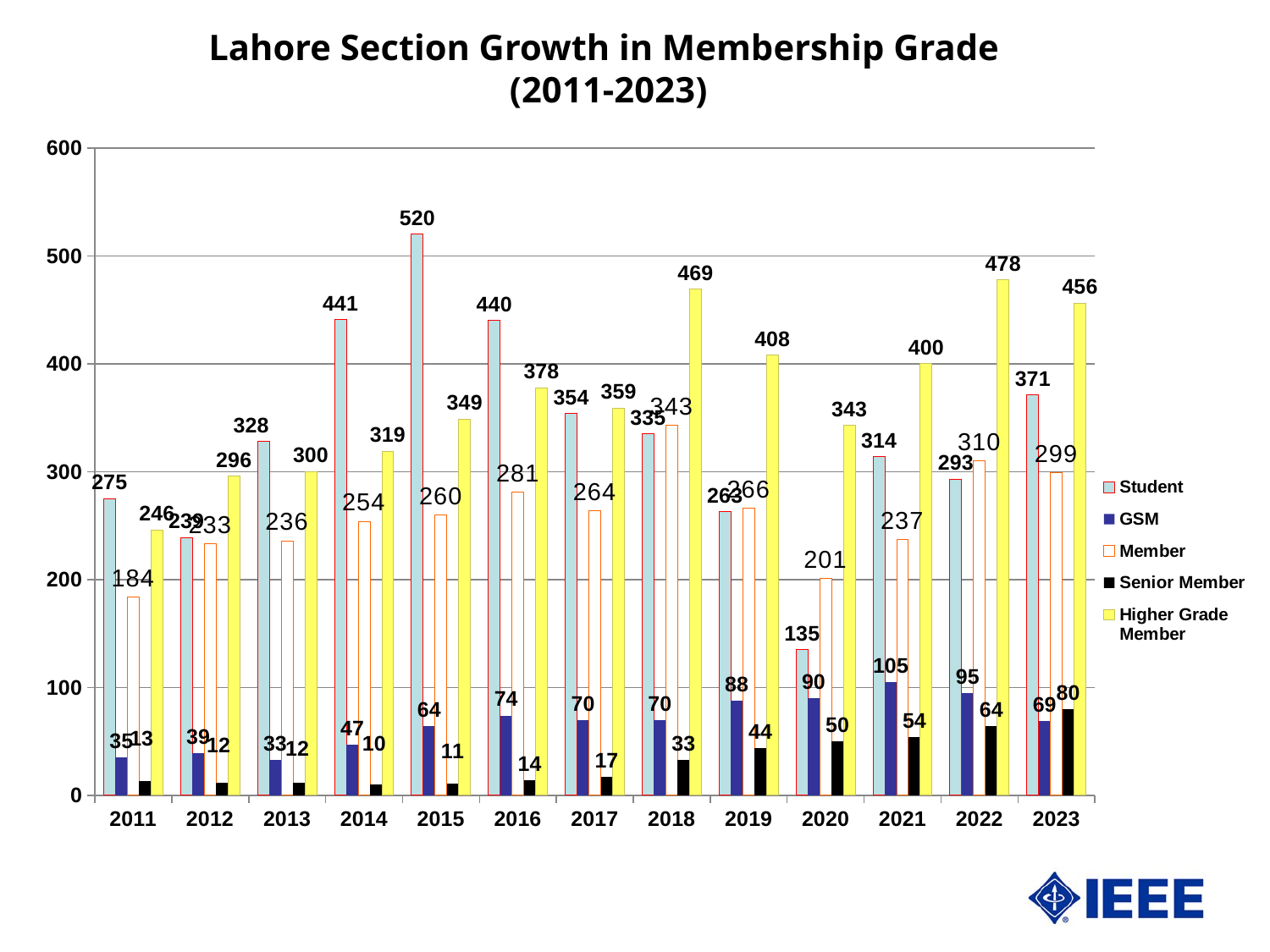
What is the Higher Grade Member value for 2022? 478 What is the difference between the Higher Grade Member values for 2022 and 2021? 78 What kind of chart is shown on the slide? bar chart In which year is the Student value highest? 2015 What is the Student value for 2015? 520 In which year is the Student value lowest? 2020 What is the GSM value for 2021? 105 How many years are shown along the x axis? 13 What is the title of the chart? Lahore Section Growth in Membership Grade (2011-2023) In 2020, which is larger: the Member value or the Student value? Member What is the Senior Member value for 2023? 80 How many series does the legend list? 5